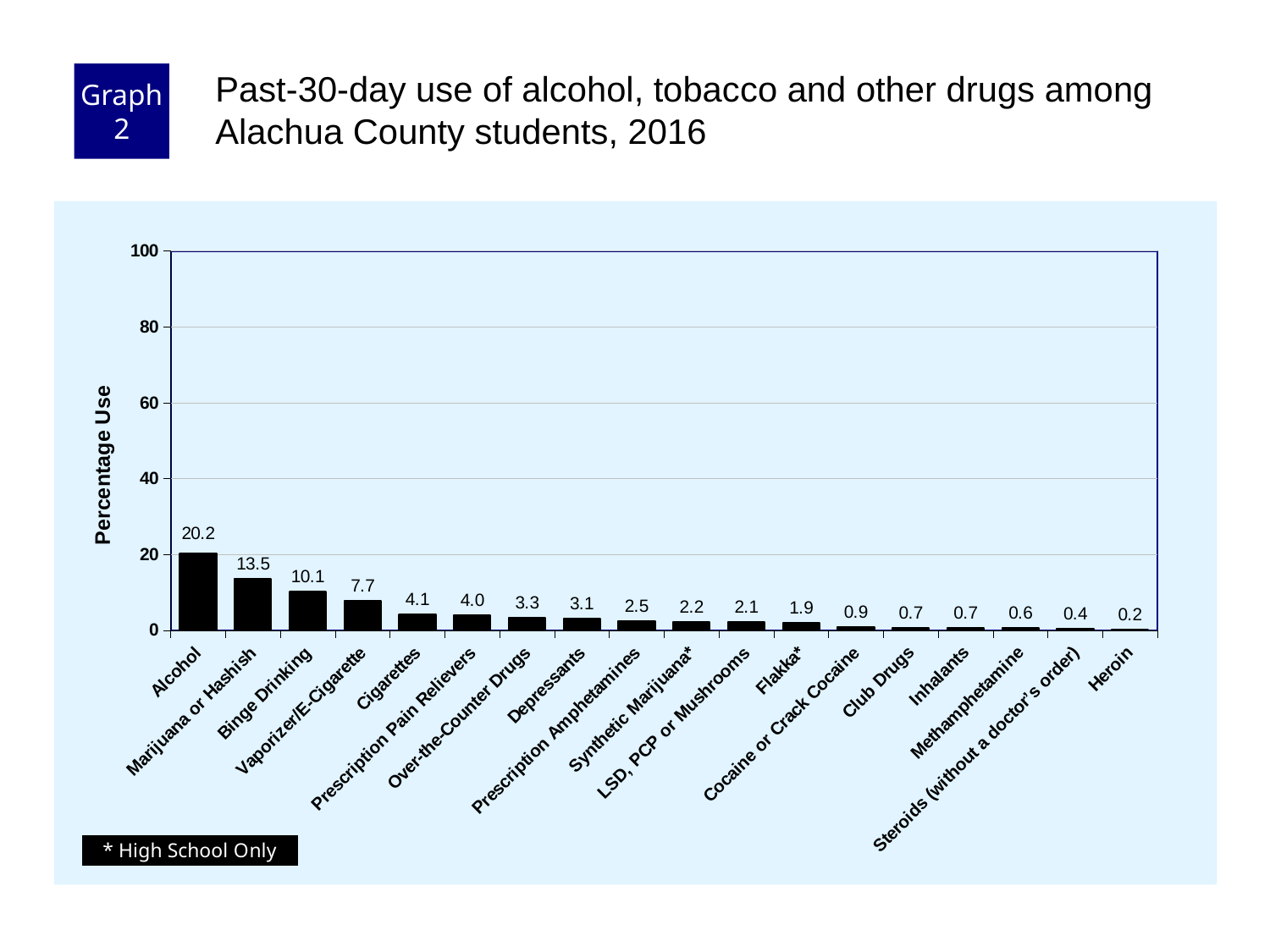
How many categories are shown on the x axis? 18 What kind of chart is shown on the slide? Bar chart What is the label of the y axis? Percentage Use What is the percentage use for Alcohol? 20.2 Which category has the lowest percentage use? Heroin What is the percentage use for Flakka*? 1.9 Which has a higher percentage use, Over-the-Counter Drugs or Prescription Amphetamines? Over-the-Counter Drugs What is the percentage use for Vaporizer/E-Cigarette? 7.7 What is the difference in percentage use between Alcohol and Marijuana or Hashish? 6.7 What is the difference in percentage use between Binge Drinking and Cigarettes? 6.0 Which category has the highest percentage use? Alcohol Is the value for Marijuana or Hashish greater or less than 20? less